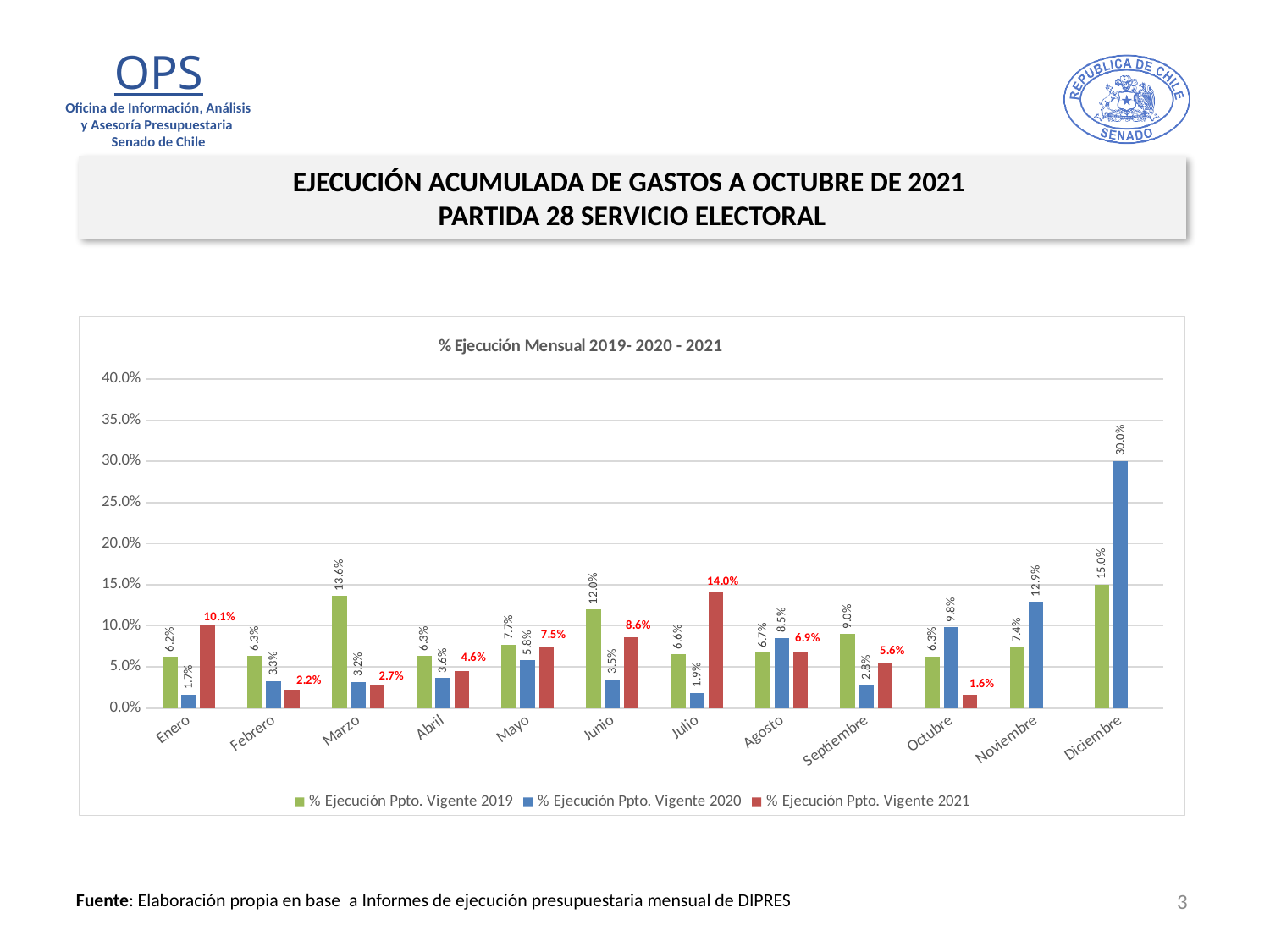
In Agosto, which series has the larger value: % Ejecución Ppto. Vigente 2019 or % Ejecución Ppto. Vigente 2020? % Ejecución Ppto. Vigente 2020 How many months are shown on the x axis? 12 What is the value for % Ejecución Ppto. Vigente 2019 in Marzo? 13.6% What is the value for % Ejecución Ppto. Vigente 2021 in Julio? 14.0% What is the difference between the 2019 and 2020 values in Enero? 4.5% What is the title of the chart? % Ejecución Mensual 2019- 2020 - 2021 What kind of chart is shown on the slide? Bar chart Which month has the lowest value for % Ejecución Ppto. Vigente 2021? Octubre Which month has the highest value for % Ejecución Ppto. Vigente 2021? Julio How many series does the legend list? 3 Is the value for % Ejecución Ppto. Vigente 2020 in Diciembre greater or less than 25.0%? greater What is the value for % Ejecución Ppto. Vigente 2020 in Diciembre? 30.0%